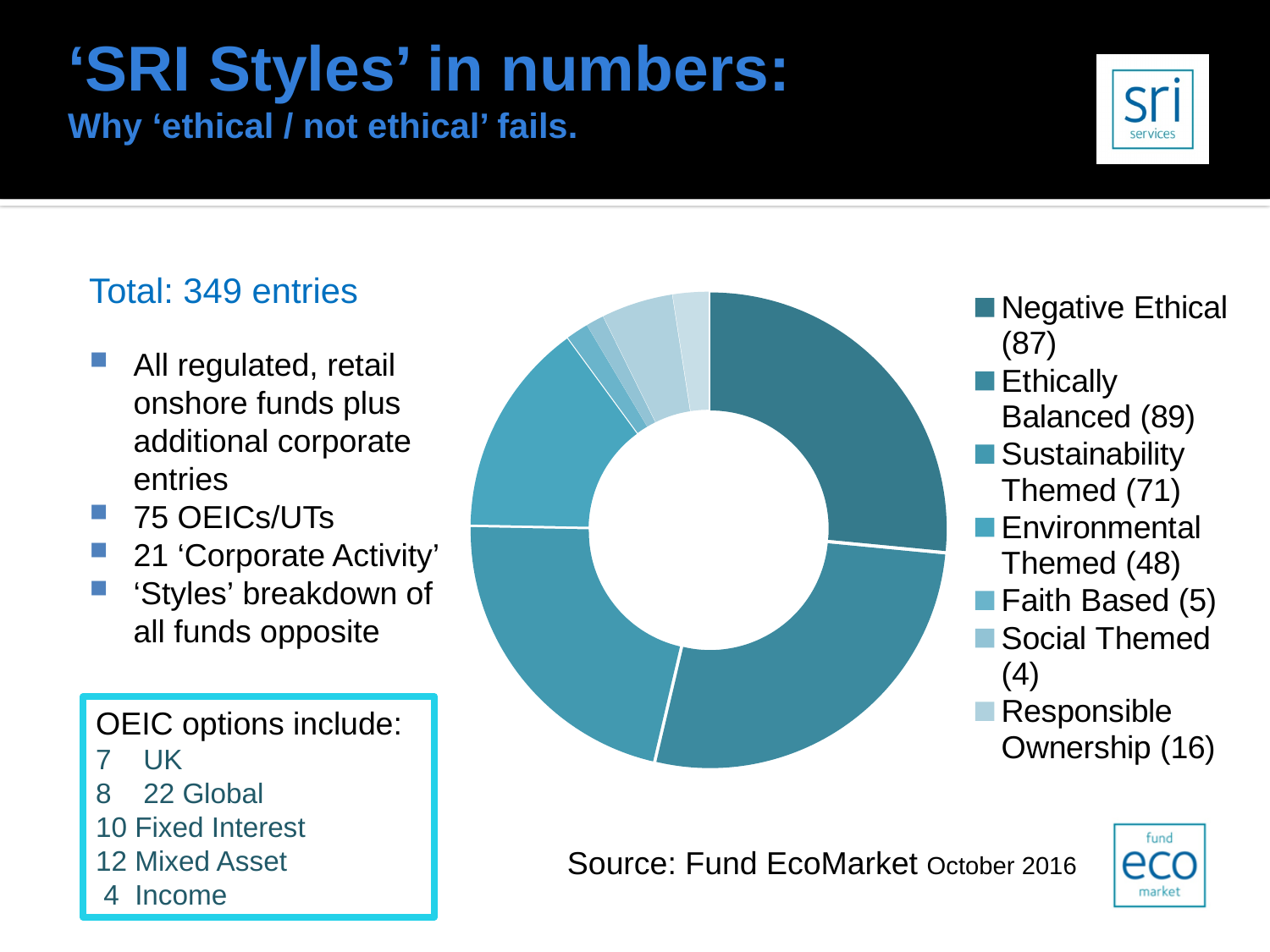
What is the difference between the values for Sustainability Themed and Environmental Themed? 23 What kind of chart is shown on the slide? doughnut chart What source is cited below the chart? Fund EcoMarket October 2016 Which category has the highest value in the chart? Ethically Balanced (89) What value is shown for Environmental Themed in the chart legend? 48 Which category has the lowest value in the chart? Social Themed (4) What value is shown for Responsible Ownership in the chart legend? 16 What value is shown for Negative Ethical in the chart legend? 87 What is the difference between the values for Ethically Balanced and Negative Ethical? 2 What value is shown for Sustainability Themed in the chart legend? 71 Which is larger, Faith Based or Social Themed? Faith Based